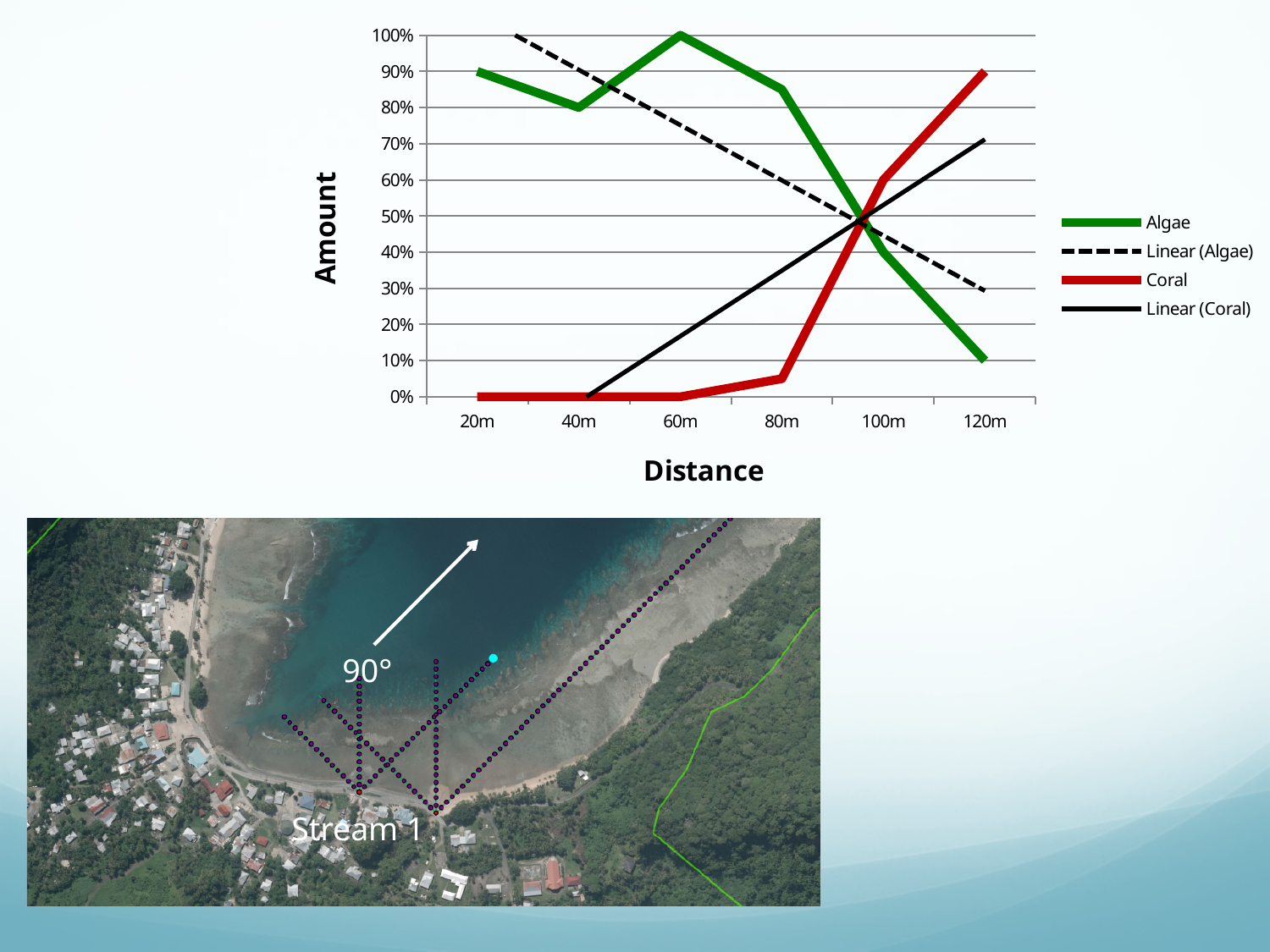
How many entries does the chart legend list? 4 What is the Coral value at 120m? 90% Is the Algae value at 80m greater or less than 70%? greater How many distance categories are shown on the x axis? 6 At which distance is the Algae value highest? 60m Which is larger at 100m, the Algae value or the Coral value? Coral What kind of chart is shown on the slide? line chart What is the Algae value at 120m? 10% At which distance is the Coral value highest? 120m Is the Coral value at 80m greater or less than 10%? less What is the Coral value at 20m? 0% What is the Algae value at 60m? 100%